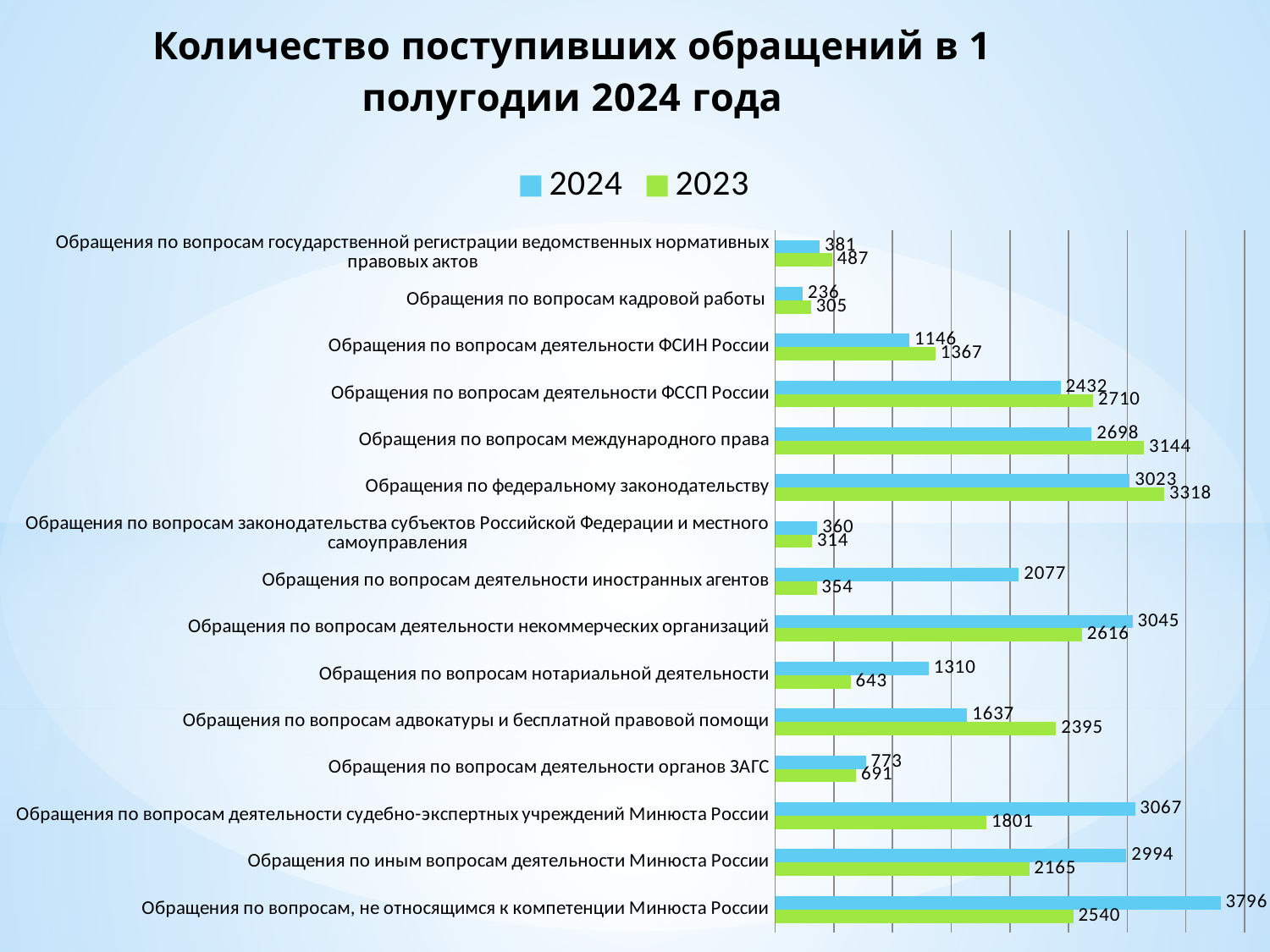
Which colour represents the 2023 series in the legend? green How many series does the legend list? 2 What is the 2023 value for «Обращения по вопросам адвокатуры и бесплатной правовой помощи»? 2395 What is the difference between the 2024 and 2023 values for «Обращения по вопросам деятельности судебно-экспертных учреждений Минюста России»? 1266 What type of chart is shown on the slide? bar chart How many categories are shown on the chart? 15 For «Обращения по вопросам нотариальной деятельности», which is larger: the 2024 value or the 2023 value? 2024 Which category has the lowest 2023 value? Обращения по вопросам кадровой работы Which category has the highest 2023 value? Обращения по федеральному законодательству What is the difference between the 2023 and 2024 values for «Обращения по вопросам международного права»? 446 What is the 2024 value for «Обращения по вопросам деятельности иностранных агентов»? 2077 Which category has the highest 2024 value? Обращения по вопросам, не относящимся к компетенции Минюста России